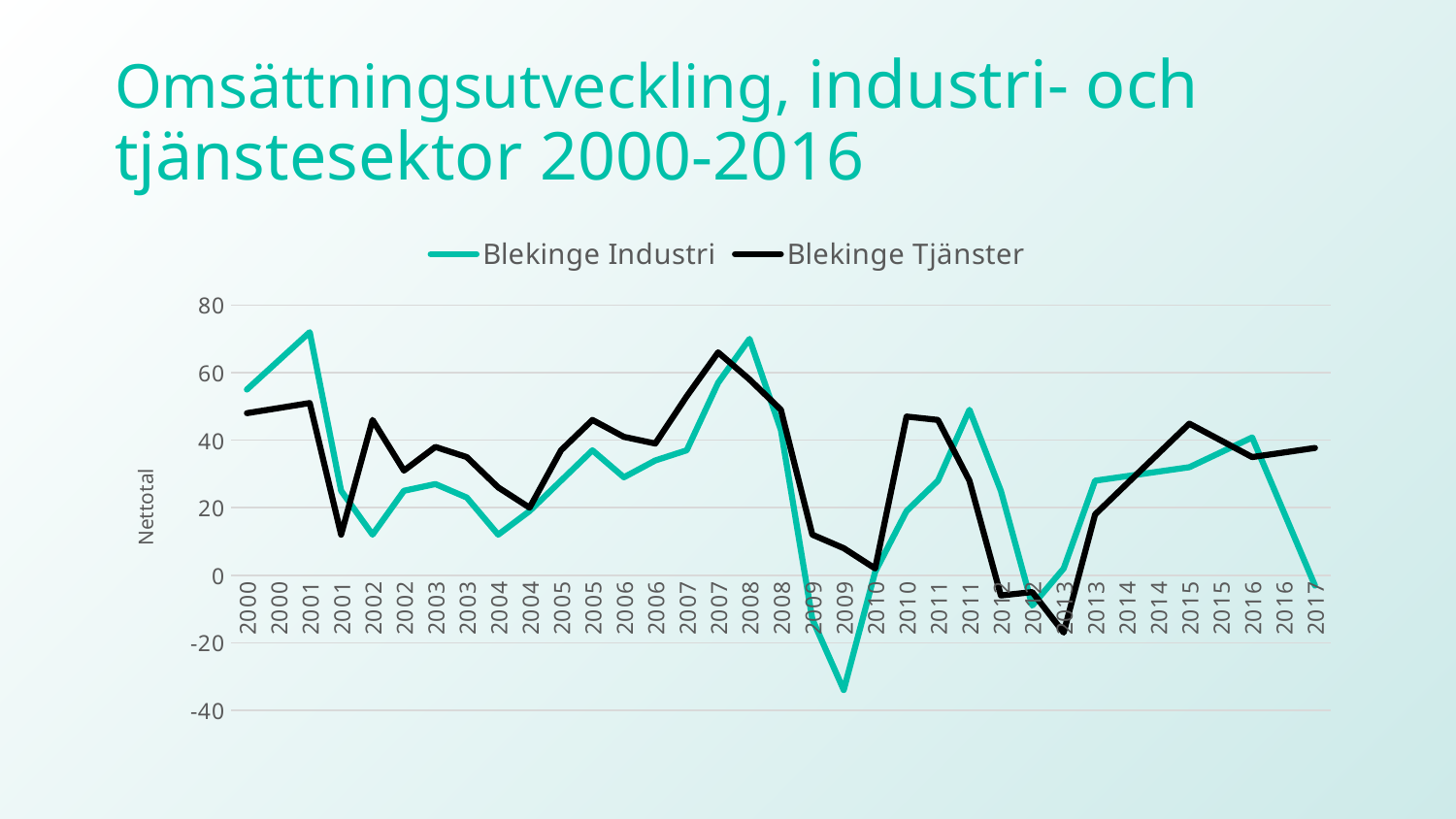
Is the lowest value of Blekinge Tjänster greater or less than 0? less Does the Blekinge Industri line rise or fall from 2016 to 2017? fall What kind of chart is shown on the slide? Line chart Which series reaches the highest value anywhere on the chart? Blekinge Industri What is the label on the vertical axis? Nettotal What are the two series named in the legend? Blekinge Industri and Blekinge Tjänster At the last point (2017), which series has the higher value, Blekinge Industri or Blekinge Tjänster? Blekinge Tjänster Which series reaches the lowest value anywhere on the chart? Blekinge Industri Is the lowest value of Blekinge Industri greater or less than -20? less At the first point (2000), which series has the higher value, Blekinge Industri or Blekinge Tjänster? Blekinge Industri Is the highest value of Blekinge Tjänster greater or less than 60? greater How many series does the legend list? 2